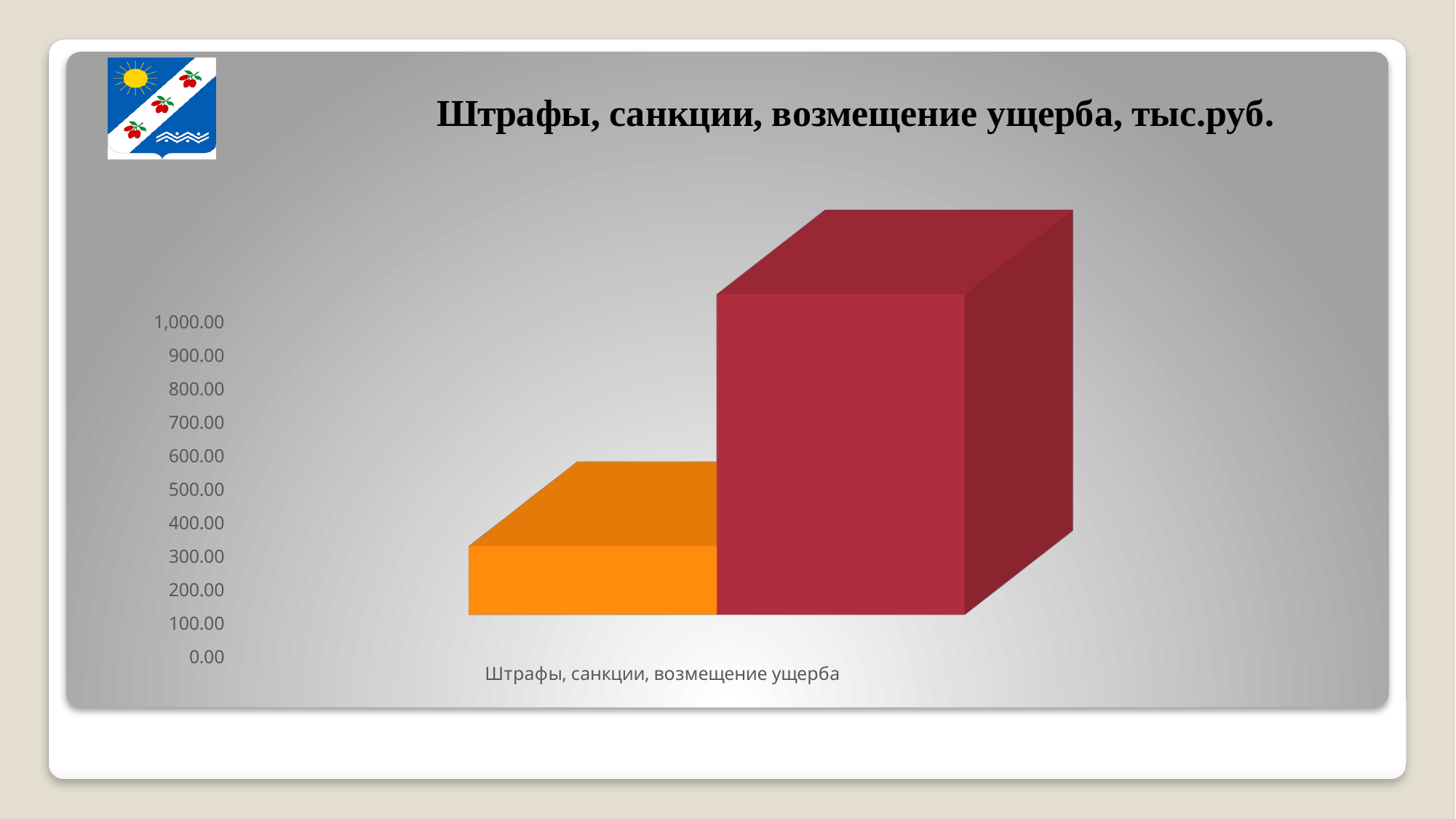
What is the highest value shown on the vertical axis? 1,000.00 Is the value of the red bar greater or less than 800.00? greater What is the category label shown on the x axis? Штрафы, санкции, возмещение ущерба What kind of chart is shown on the slide? bar chart Which bar is taller, the orange bar or the red bar? the red bar What is the title of the chart? Штрафы, санкции, возмещение ущерба, тыс.руб. Is the value of the orange bar greater or less than 500.00? less How many categories are shown on the x axis of the chart? 1 Which bar shows the lowest value? the orange bar